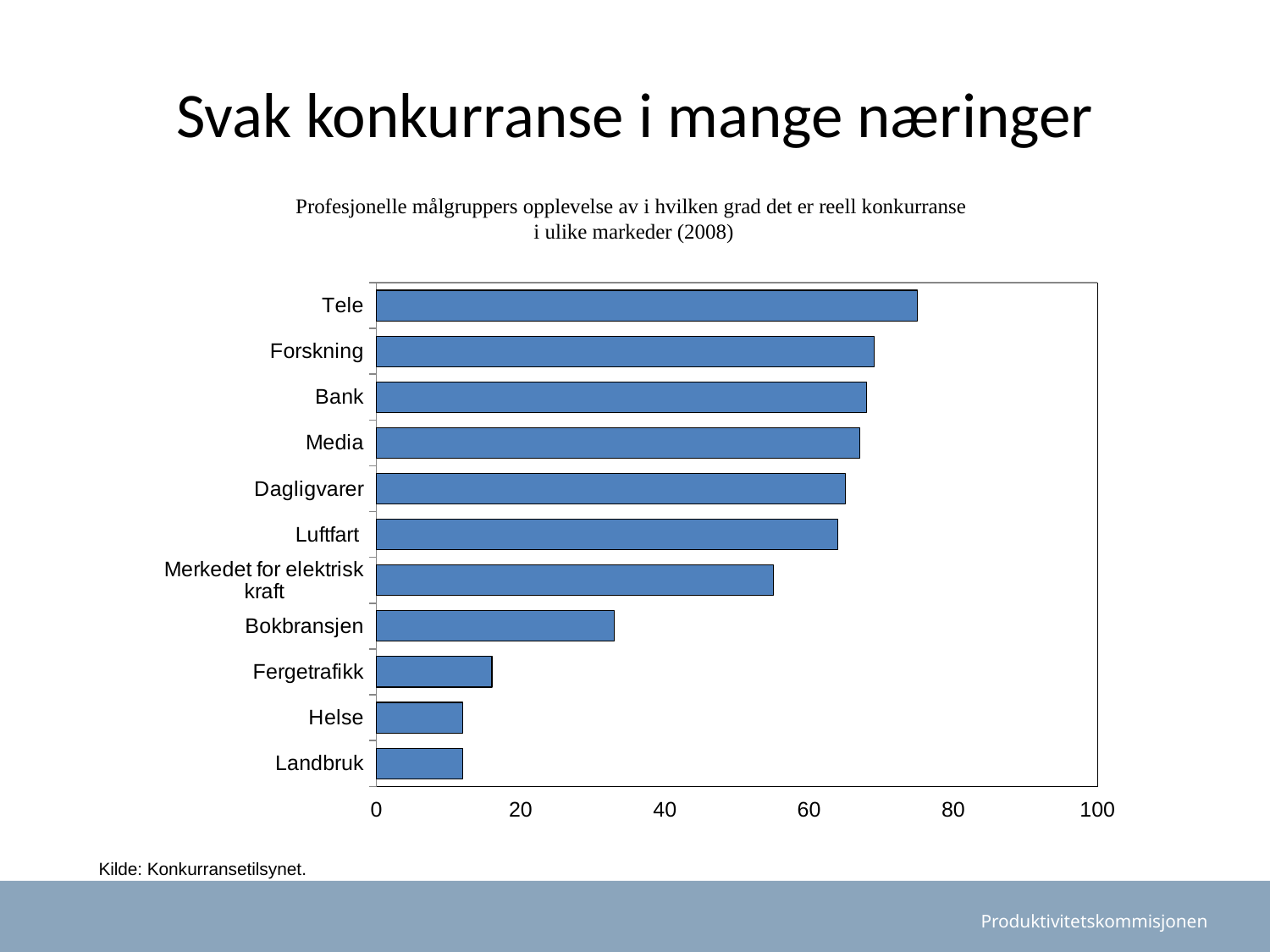
Which has a larger value, Luftfart or Bokbransjen? Luftfart Which market has the highest value in the chart? Tele Is the value for Tele greater or less than 60? greater Is the value for Helse greater or less than 20? less Is the value for Merkedet for elektrisk kraft greater or less than 40? greater How many categories (markets) are shown in the chart? 11 What kind of chart is shown on the slide? Bar chart Which has a larger value, Fergetrafikk or Merkedet for elektrisk kraft? Merkedet for elektrisk kraft What is the maximum value shown on the horizontal axis of the chart? 100 What source is cited for the chart on the slide? Konkurransetilsynet